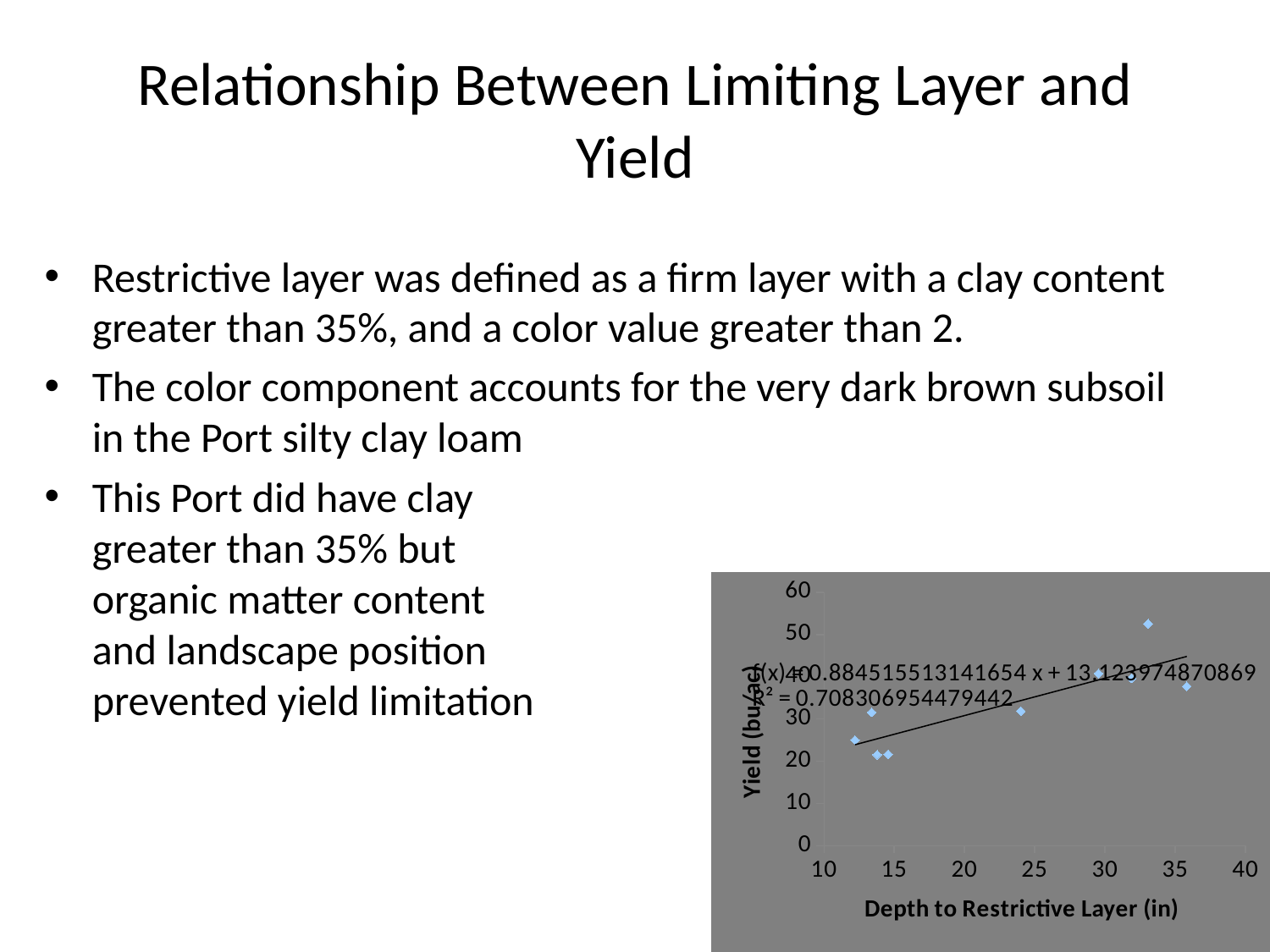
What R² value is printed on the chart for the trendline? 0.7083069544479442 What is the title of the x axis of the chart? Depth to Restrictive Layer (in) Is the lowest yield value plotted on the chart greater or less than 30? less What is the intercept of the trendline equation printed on the chart? 13.123974870869 What is the slope of the trendline equation printed on the chart? 0.884515513141654 What kind of chart is shown on the slide? scatter chart Is the highest yield value plotted on the chart greater or less than 40? greater What is the maximum value shown on the y axis of the chart? 60 Does yield generally rise or fall as depth to restrictive layer increases along the x axis? rise What is the title of the y axis of the chart? Yield (bu/ac) Is the largest depth to restrictive layer plotted on the chart greater or less than 40? less